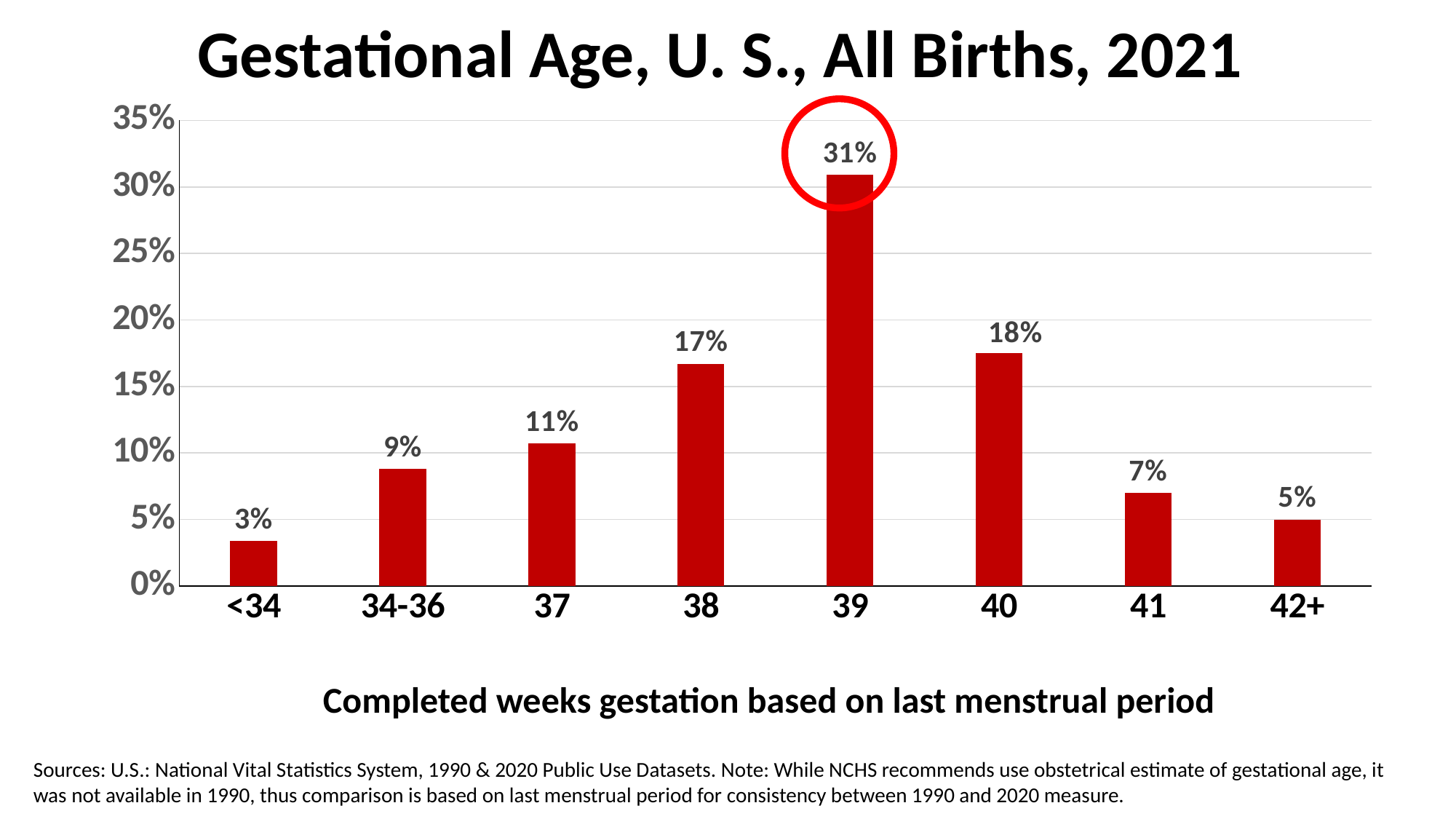
What percentage of births is shown for 42+ weeks? 5% What is the title of the chart? Gestational Age, U. S., All Births, 2021 What kind of chart is shown on the slide? Bar chart What is the difference between the values for 38 weeks and 37 weeks? 6% What is the value shown for the <34 weeks category? 3% What is the difference between the values for 39 weeks and 40 weeks? 13% Which gestational age category has the lowest share of births? <34 Which has a larger value, 34-36 weeks or 41 weeks? 34-36 How many gestational age categories are shown on the x axis? 8 Which gestational age category has the highest share of births? 39 Is the value for 40 weeks greater or less than 15%? greater What percentage of births occurred at 39 completed weeks of gestation? 31%